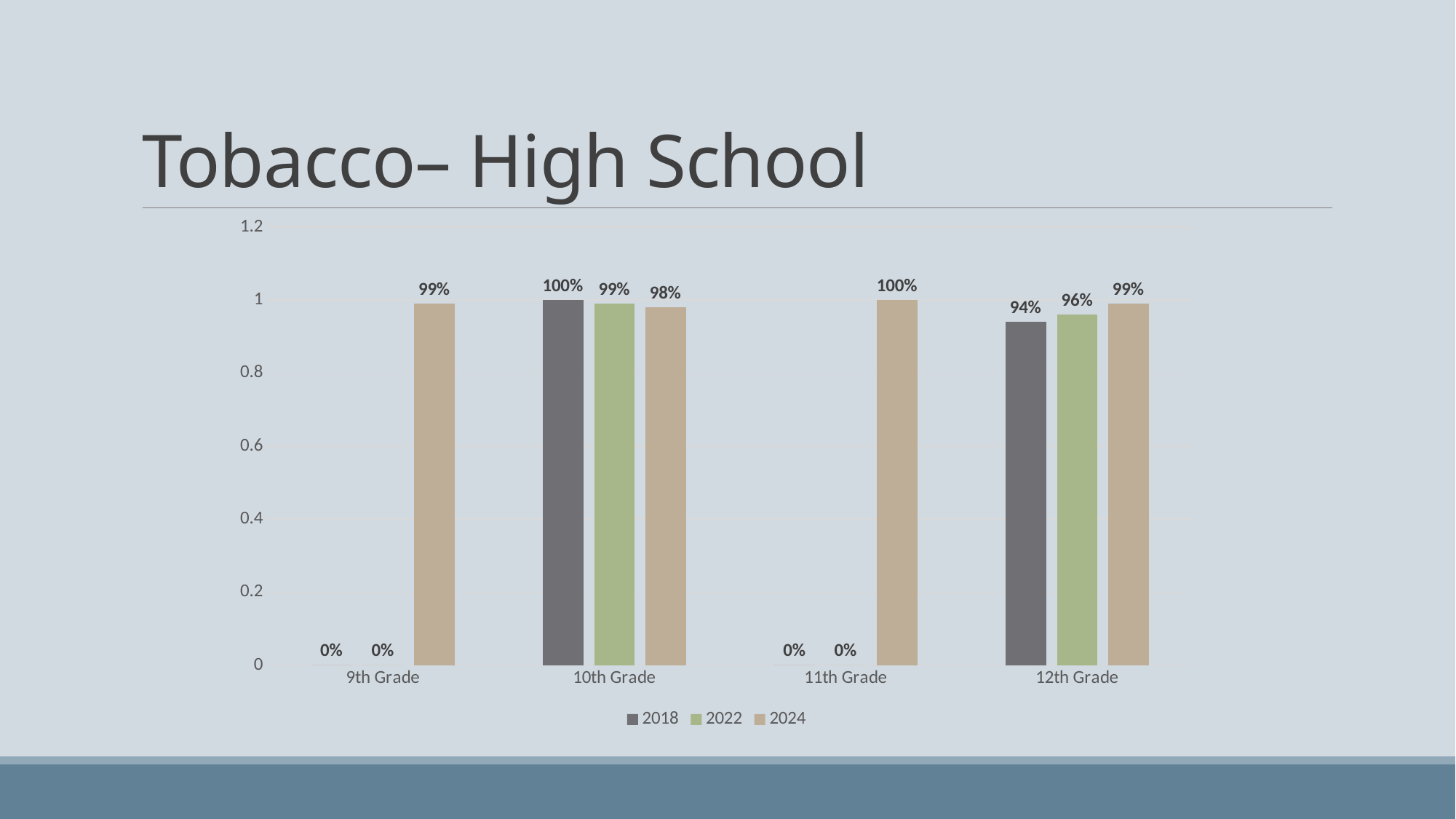
What is the title of the slide? Tobacco– High School What is the value for 2024 for 11th Grade? 100% Which grade has the lowest value for 2018 among the grades with a non-zero value? 12th Grade How many series does the legend list? 3 What is the value for 2018 for 10th Grade? 100% What kind of chart is shown on the slide? Bar chart What is the value for 2024 for 9th Grade? 99% What is the difference between the 2024 value and the 2018 value for 12th Grade? 5% What is the value for 2022 for 12th Grade? 96% How many grade categories are shown on the x axis? 4 What is the value for 2018 for 9th Grade? 0% Which is larger for 10th Grade: the 2022 value or the 2024 value? 2022